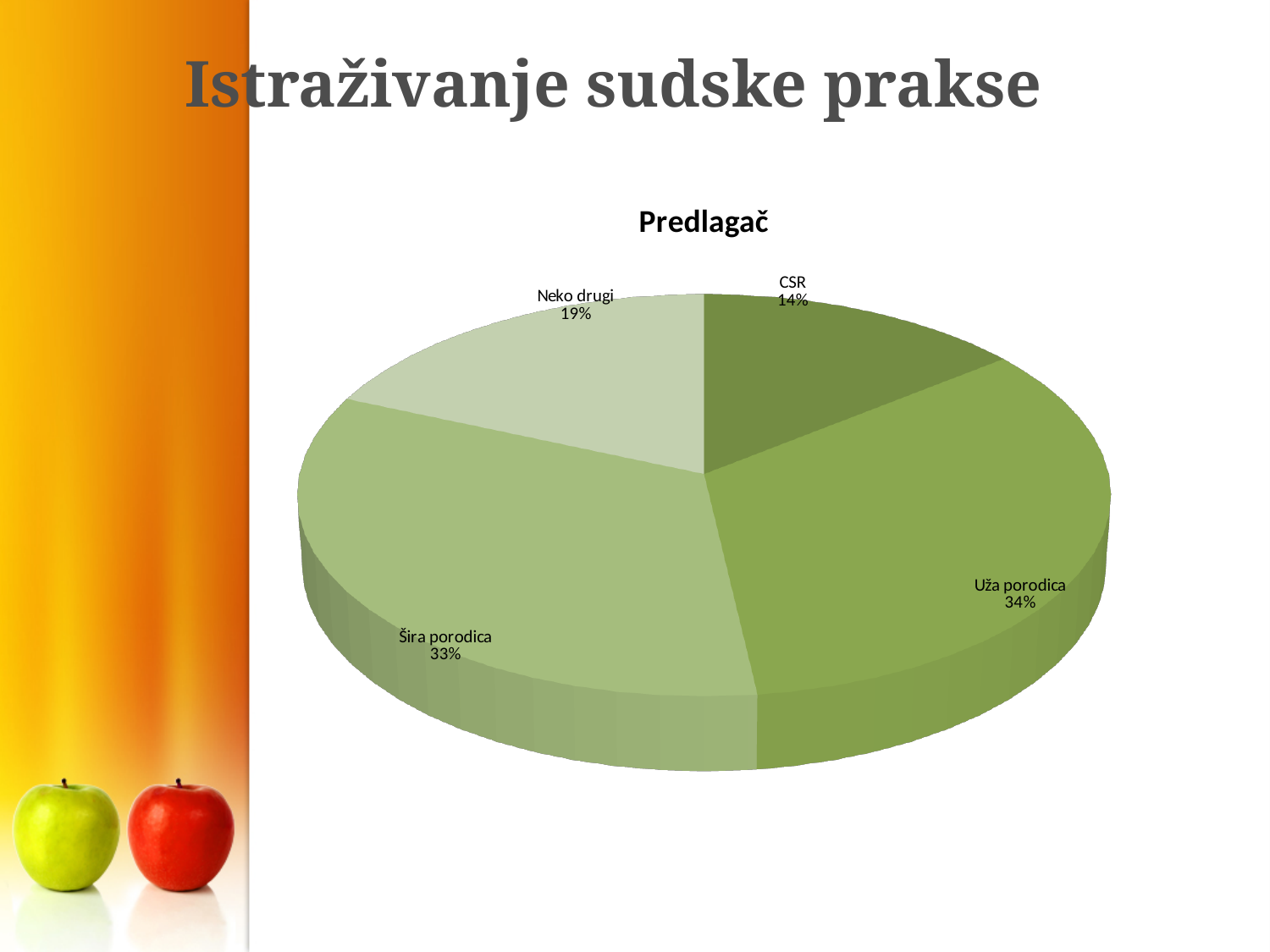
What share of the pie does Šira porodica have? 33% Which is larger, the share for Neko drugi or the share for CSR? Neko drugi How many slices does the pie chart have? 4 What is the title of the chart? Predlagač Which category has the smallest slice of the pie? CSR What share of the pie does Uža porodica have? 34% What is the difference in percentage points between Uža porodica and Neko drugi? 15 What is the difference in percentage points between Neko drugi and CSR? 5 Which is larger, the share for Šira porodica or the share for Neko drugi? Šira porodica What share of the pie does Neko drugi have? 19% What type of chart is shown on the slide? Pie chart